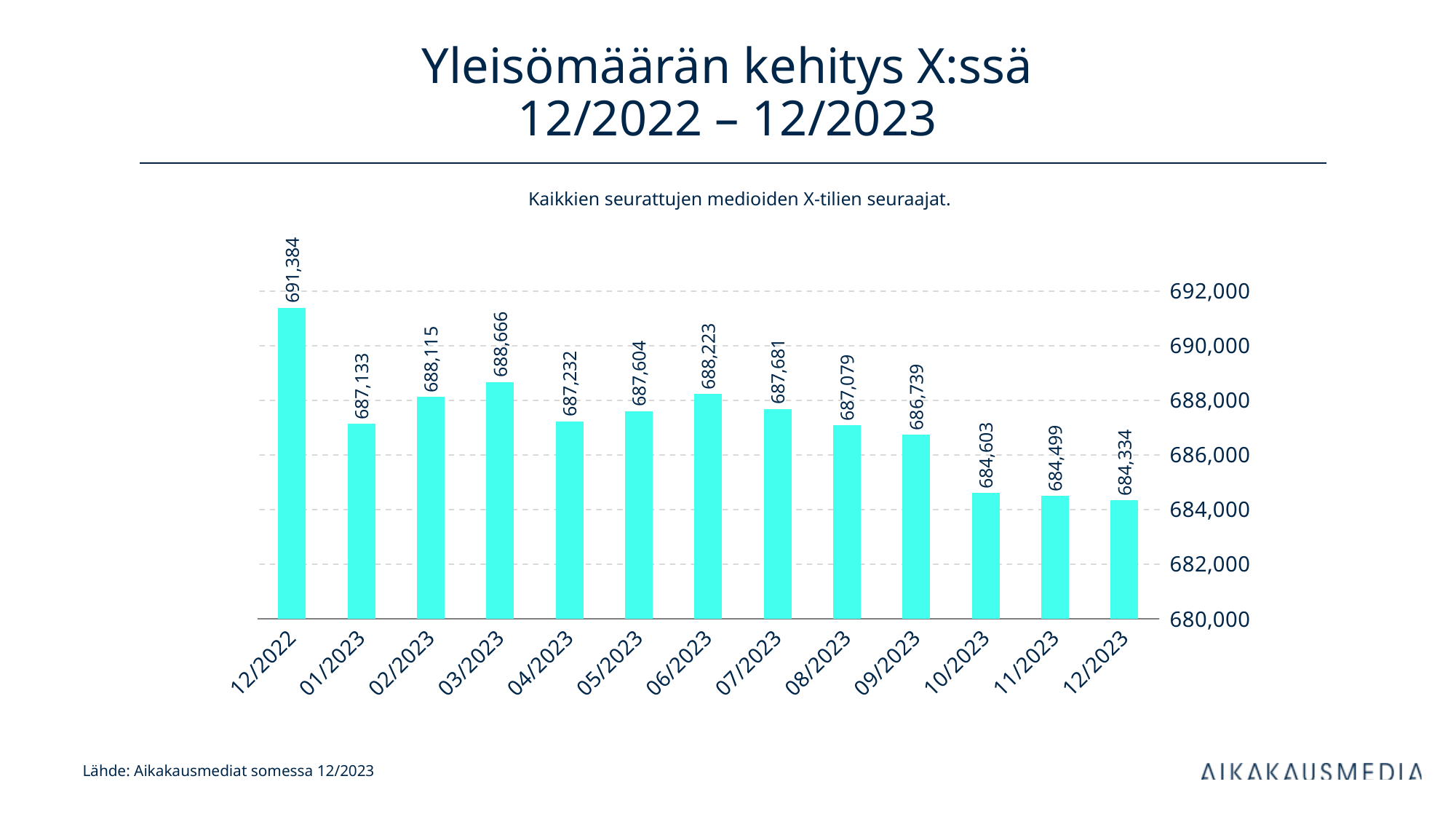
What is the value for 06/2023? 688,223 What is the difference between the values for 12/2022 and 12/2023? 7,050 How many months are shown on the x axis? 13 Do the values generally rise or fall from 12/2022 to 12/2023? fall What kind of chart is shown on the slide? bar chart What is the value for 12/2022? 691,384 What is the value for 12/2023? 684,334 Which month has the highest value? 12/2022 Which month has the lowest value? 12/2023 Is the value for 10/2023 greater or less than 686,000? less Which is larger, the value for 03/2023 or the value for 04/2023? 03/2023 What is the title of the chart? Yleisömäärän kehitys X:ssä 12/2022 – 12/2023